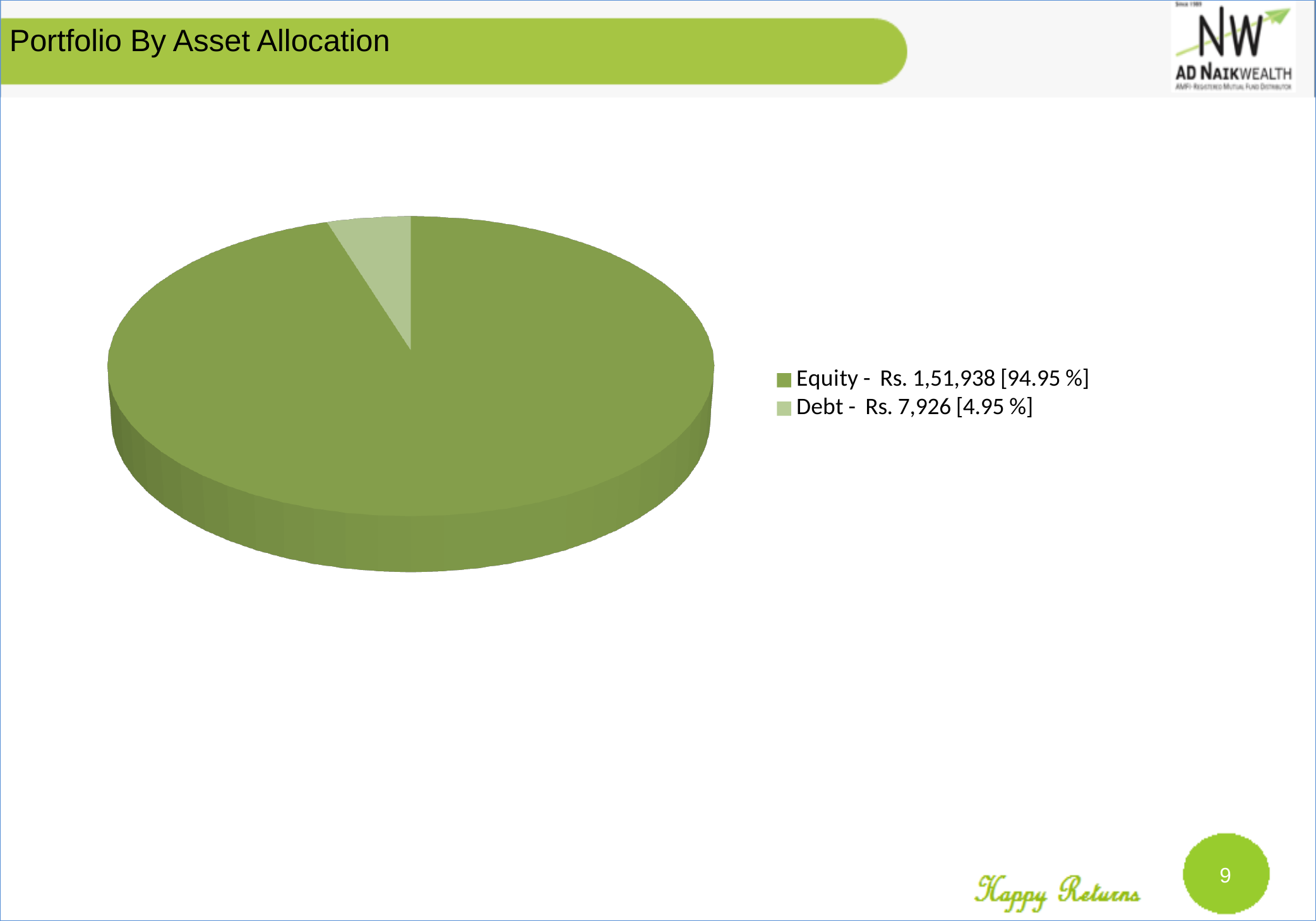
What is the difference between the Equity and Debt values? Rs. 1,44,012 What share of the pie does Equity represent? 94.95 % Which category has the largest slice? Equity What is the title of the slide containing the chart? Portfolio By Asset Allocation Which is larger, Equity or Debt? Equity What type of chart is shown on the slide? pie chart How many categories are shown in the pie chart? 2 Which category is shown in the lighter green colour? Debt Which category has the smallest slice? Debt What share of the pie does Debt represent? 4.95 % What is the value for Equity? Rs. 1,51,938 What is the value for Debt? Rs. 7,926